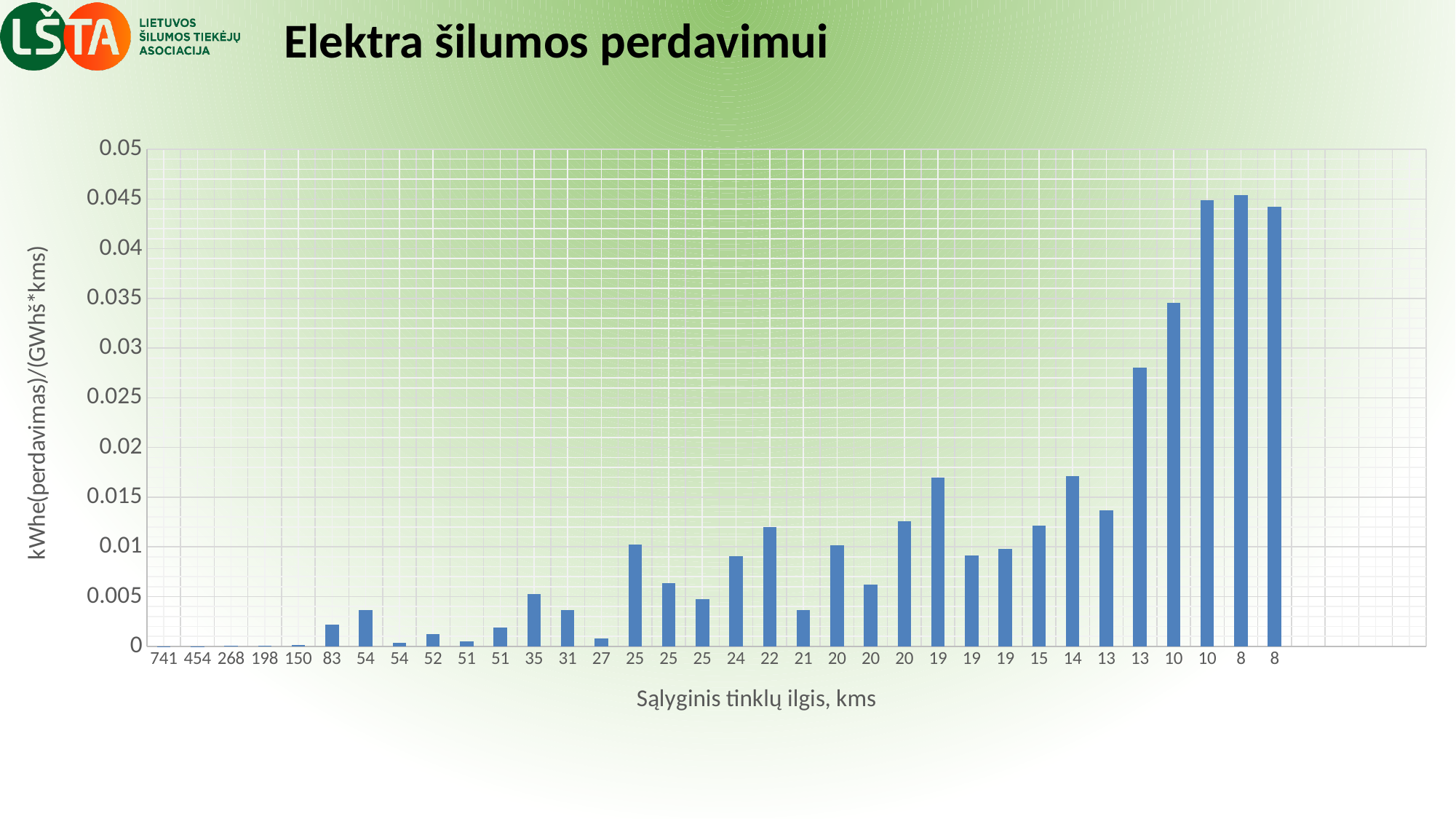
How many bars are plotted in the chart? 34 Is the value for the bar labelled 27 greater or less than 0.005? less What is the x-axis title of the chart? Sąlyginis tinklų ilgis, kms Do the bar values generally rise or fall from left to right along the x axis? rise Which bar has the larger value, the one labelled 22 or the one labelled 24? 22 Is the value for the bar labelled 83 greater or less than 0.005? less Is the value for the bar labelled 14 greater or less than 0.015? greater What kind of chart is shown on the slide? bar chart What is the title of the chart on the slide? Elektra šilumos perdavimui Which bar has the larger value, the one labelled 14 or the one labelled 15? 14